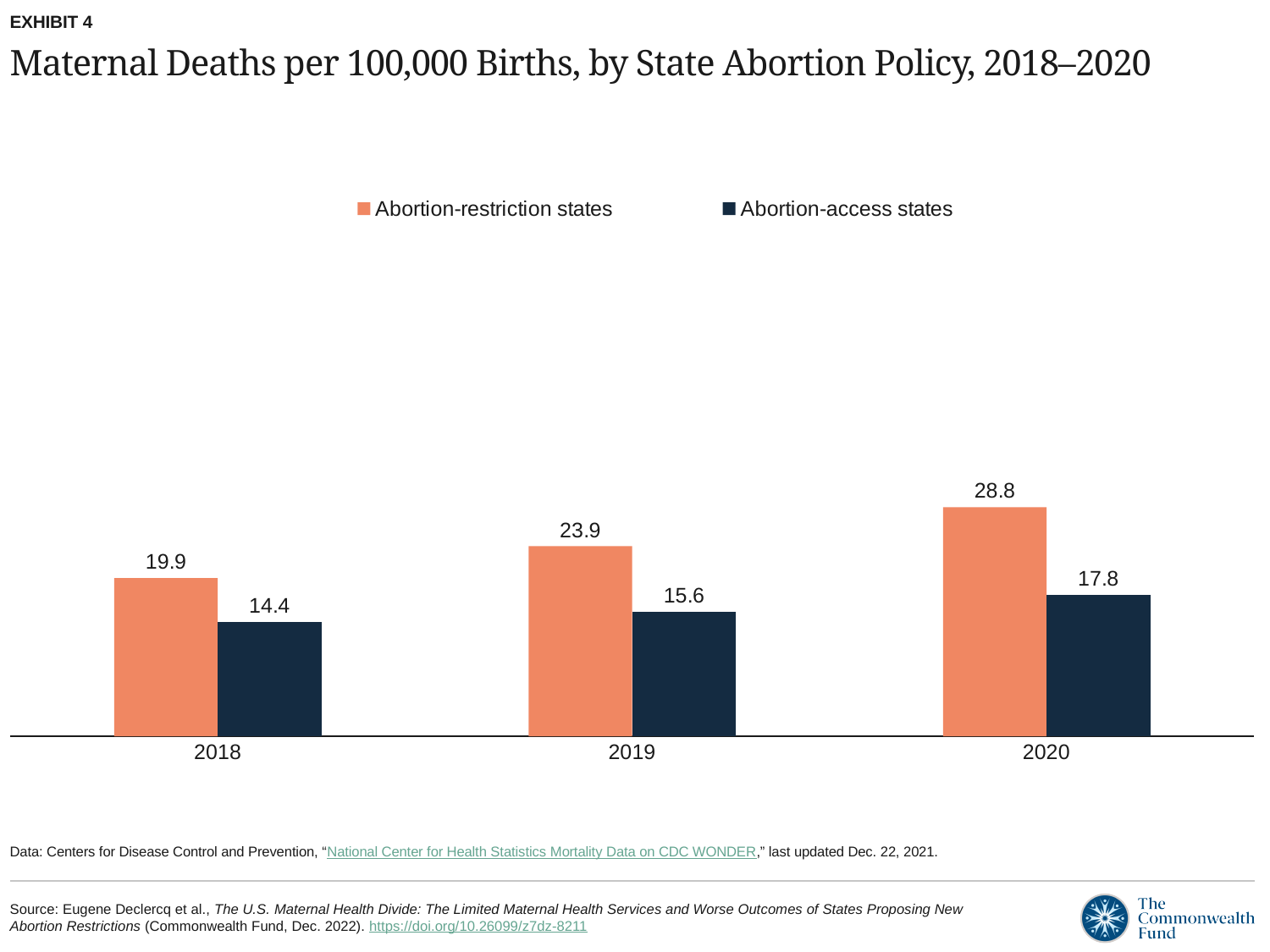
Which is larger in 2018: abortion-restriction states or abortion-access states? Abortion-restriction states In which year is the value for abortion-access states lowest? 2018 Do the values for abortion-restriction states rise or fall from 2018 to 2020? Rise What kind of chart is shown on the slide? Bar chart In which year is the value for abortion-restriction states highest? 2020 What is the maternal death rate for abortion-restriction states in 2018? 19.9 What is the difference between abortion-restriction states and abortion-access states in 2019? 8.3 What is the difference between abortion-restriction states and abortion-access states in 2020? 11.0 What is the value for abortion-access states in 2019? 15.6 How many series does the legend list? 2 What is the maternal death rate for abortion-access states in 2020? 17.8 How many years are shown on the x axis? 3